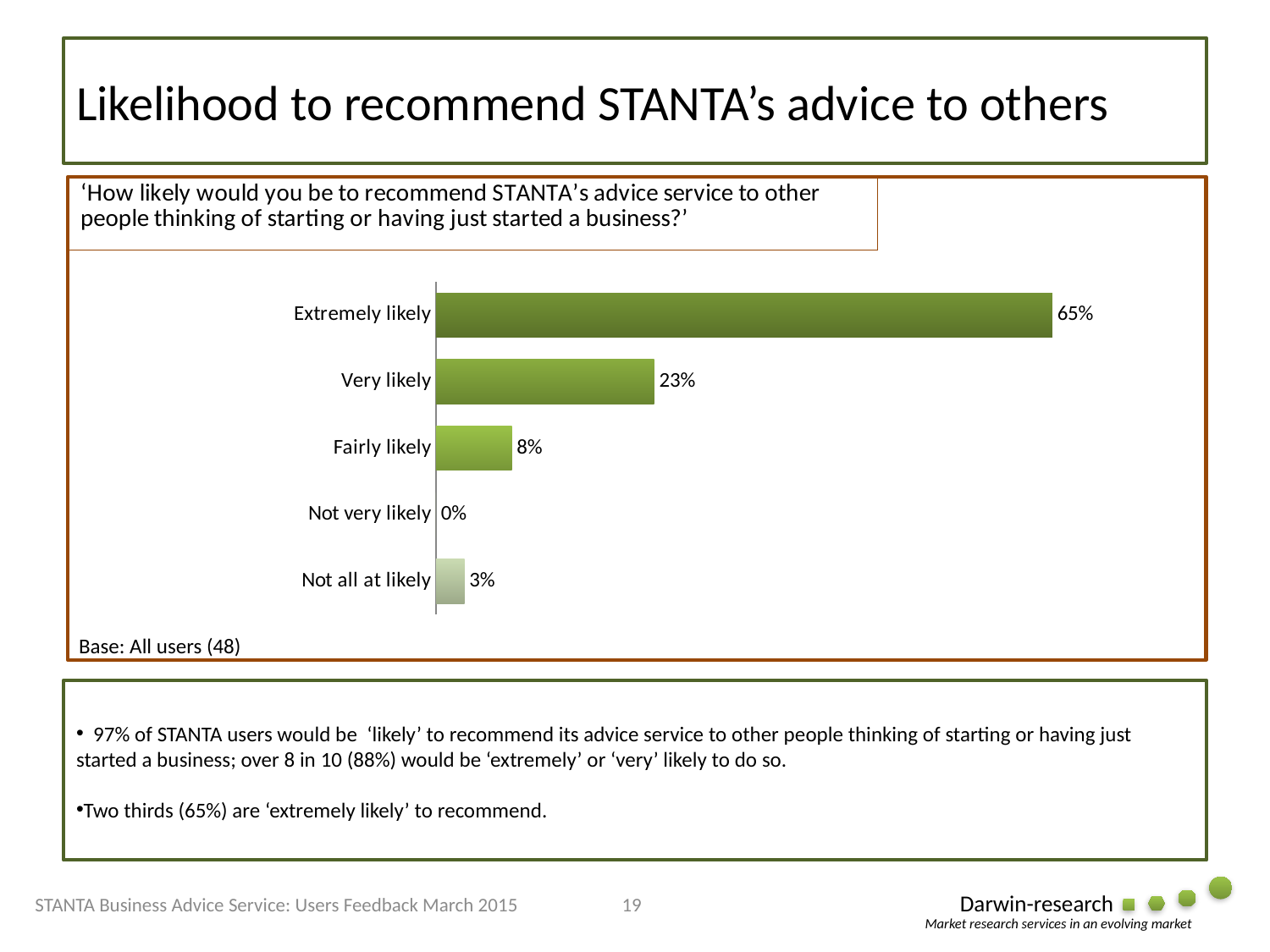
What percentage of users are 'Not very likely' to recommend STANTA's advice service? 0% What percentage of users are 'Very likely' to recommend STANTA's advice service? 23% How many categories are shown in the chart? 5 Which category has the highest percentage in the chart? Extremely likely What is the base (number of respondents) stated for the chart? All users (48) What kind of chart is shown on the slide? Bar chart Which is larger, the value for 'Fairly likely' or the value for 'Not all at likely'? Fairly likely Which category has the lowest percentage in the chart? Not very likely What percentage of users are 'Not all at likely' to recommend STANTA's advice service? 3% What percentage of users are 'Extremely likely' to recommend STANTA's advice service? 65% What percentage of users are 'Fairly likely' to recommend STANTA's advice service? 8% What is the difference in percentage points between 'Extremely likely' and 'Very likely'? 42